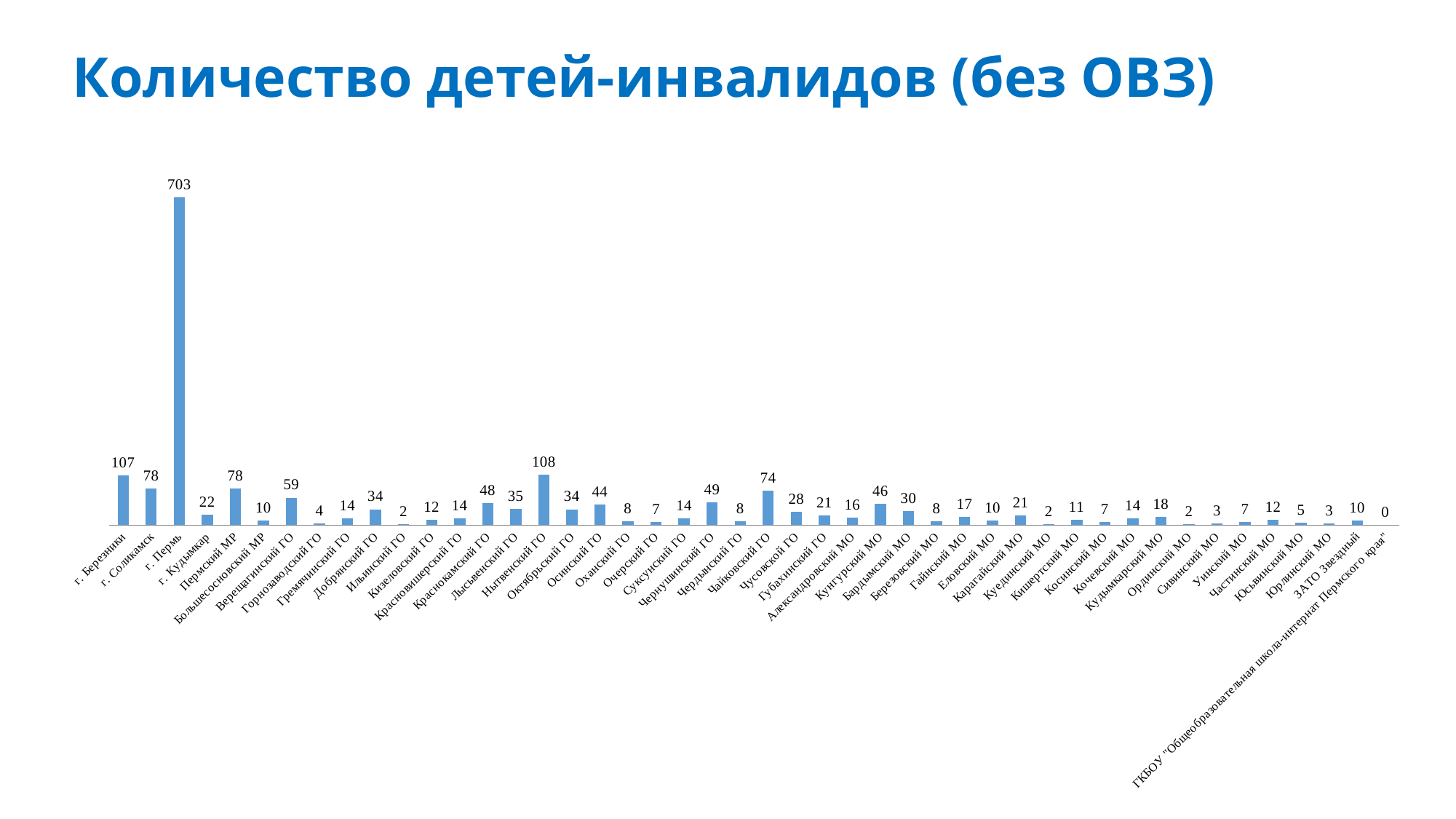
What is the value for г. Пермь? 703 What is the value for Чайковский ГО? 74 Which category has the lowest value? ГКБОУ "Общеобразовательная школа-интернат Пермского края" What is the title of the chart? Количество детей-инвалидов (без ОВЗ) Which category has the highest value? г. Пермь What type of chart is shown on the slide? bar chart What is the value for ЗАТО Звездный? 10 What is the difference between the values for г. Березники and г. Соликамск? 29 What is the difference between the values for г. Пермь and Нытвенский ГО? 595 What is the value for Кунгурский МО? 46 Which is larger, the value for Краснокамский ГО or the value for Лысьвенский ГО? Краснокамский ГО What is the value for Нытвенский ГО? 108